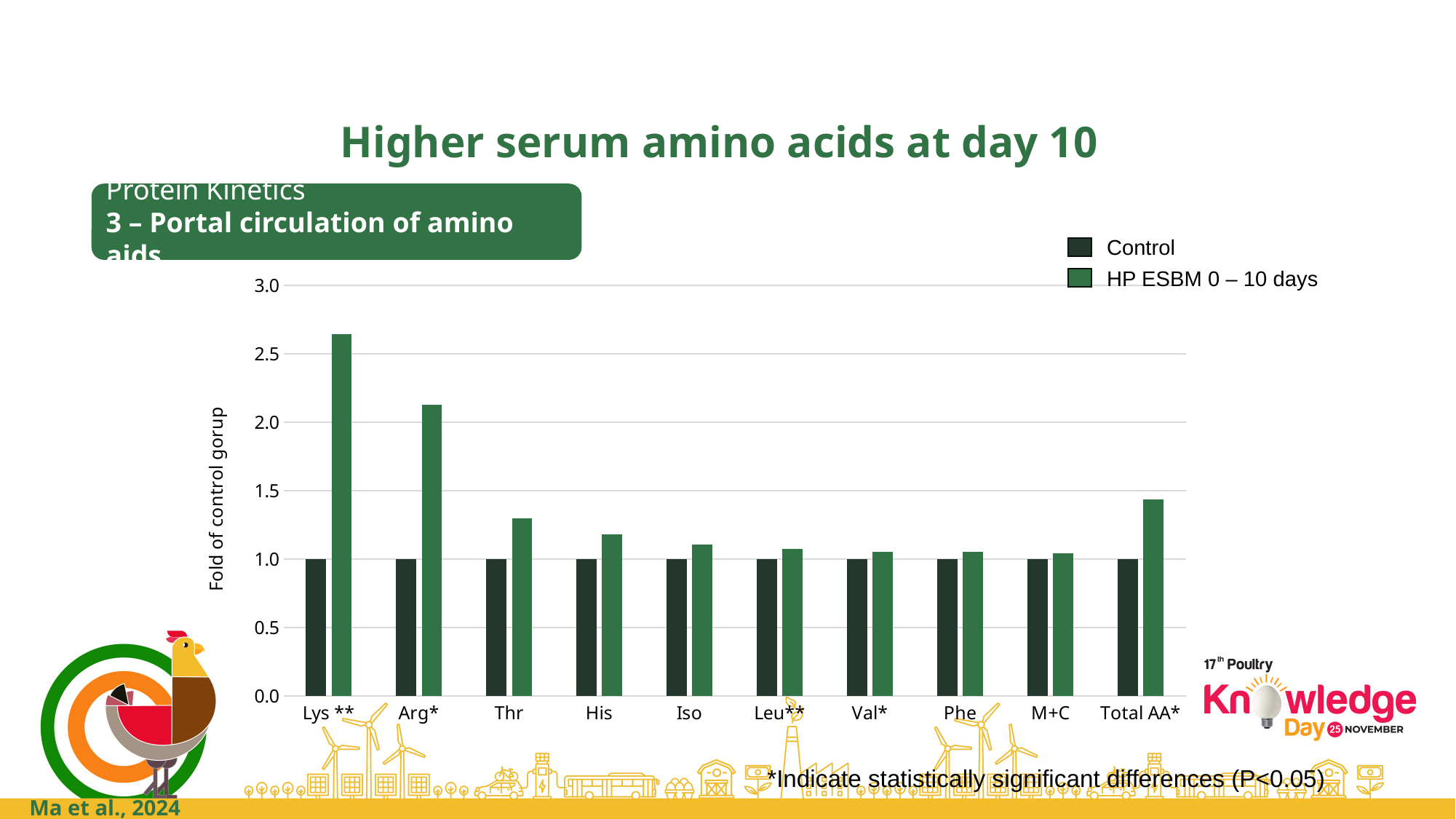
What is the value of the Control bar for Thr? 1.0 What is the label of the y axis? Fold of control gorup Which is larger, the HP ESBM 0 – 10 days value for Lys ** or for Arg*? Lys ** Is the HP ESBM 0 – 10 days value for Total AA* greater or less than 1.5? less How many amino acid categories are shown on the x axis? 10 What kind of chart is shown on the slide? bar chart Is the HP ESBM 0 – 10 days value for Arg* greater or less than 2.0? greater Which category has the highest HP ESBM 0 – 10 days value? Lys ** Is the HP ESBM 0 – 10 days value for Lys ** greater or less than 2.5? greater How many series does the legend list? 2 Which is larger, the HP ESBM 0 – 10 days value for Thr or for His? Thr